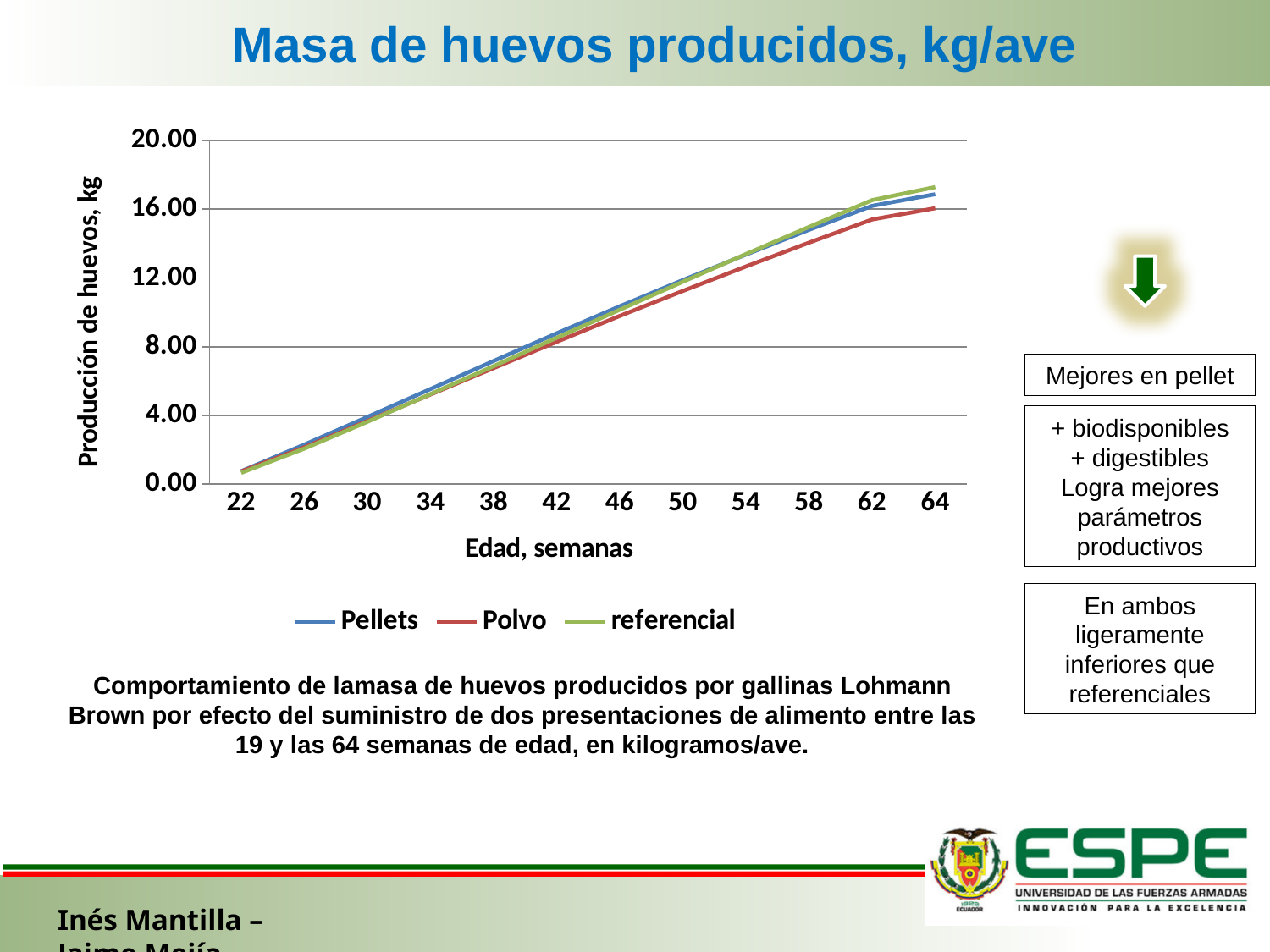
At 64 weeks, which series has the highest value? referencial Which series are listed in the legend? Pellets, Polvo, referencial Do the values for Pellets rise or fall as age in weeks increases? rise Is the value for Polvo at 62 weeks greater or less than 16.00? less At 64 weeks, which series has the lowest value? Polvo Is the value for Polvo at 58 weeks greater or less than 12.00? greater Is the value for referencial at 22 weeks greater or less than 4.00? less At 62 weeks, which is larger, the value for Pellets or the value for Polvo? Pellets What kind of chart is shown on the slide? line chart What is the title of the x axis? Edad, semanas How many series does the legend list? 3